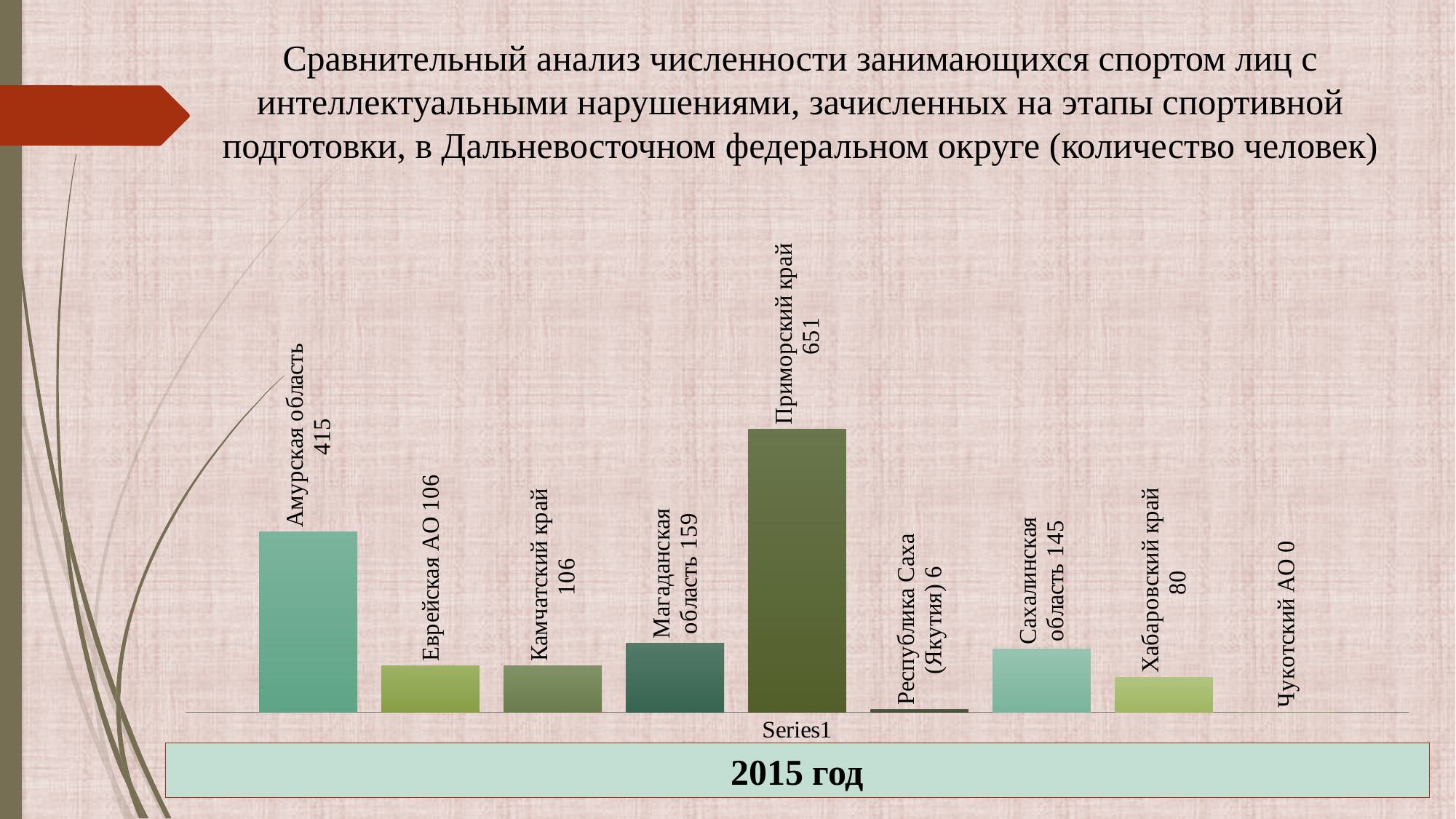
What is the difference between the values for Приморский край and Амурская область? 236 What is the value for Чукотский АО? 0 How many regions are shown in the chart? 9 What is the value for Амурская область? 415 What is the value for Приморский край? 651 What is the value for Хабаровский край? 80 What kind of chart is shown on the slide? Bar chart Which region has the highest value? Приморский край What year is shown in the label below the chart? 2015 год What is the value for Магаданская область? 159 Which region has the lowest value? Чукотский АО Which is larger, the value for Сахалинская область or the value for Магаданская область? Магаданская область